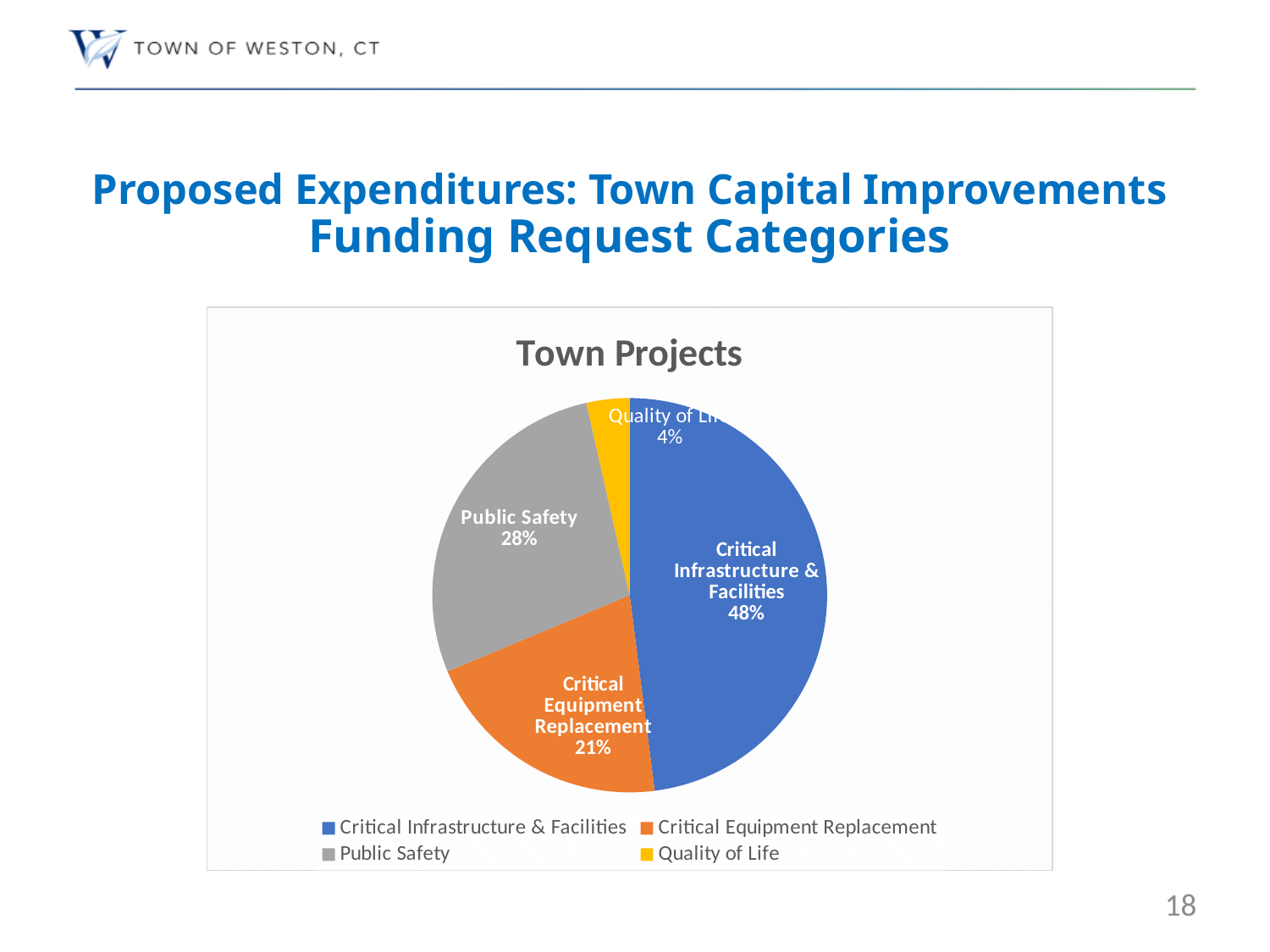
What is the title of the chart? Town Projects What share of the pie does Public Safety represent? 28% What type of chart is shown on the slide? Pie chart Which category has the smallest share of the pie? Quality of Life What share of the pie does Critical Infrastructure & Facilities represent? 48% What share of the pie does Quality of Life represent? 4% Which is larger, the share for Public Safety or the share for Critical Equipment Replacement? Public Safety How many categories are shown in the pie chart? 4 What is the difference in percentage points between Public Safety and Critical Equipment Replacement? 7 Which category has the largest share of the pie? Critical Infrastructure & Facilities What colour is the Public Safety slice? Gray